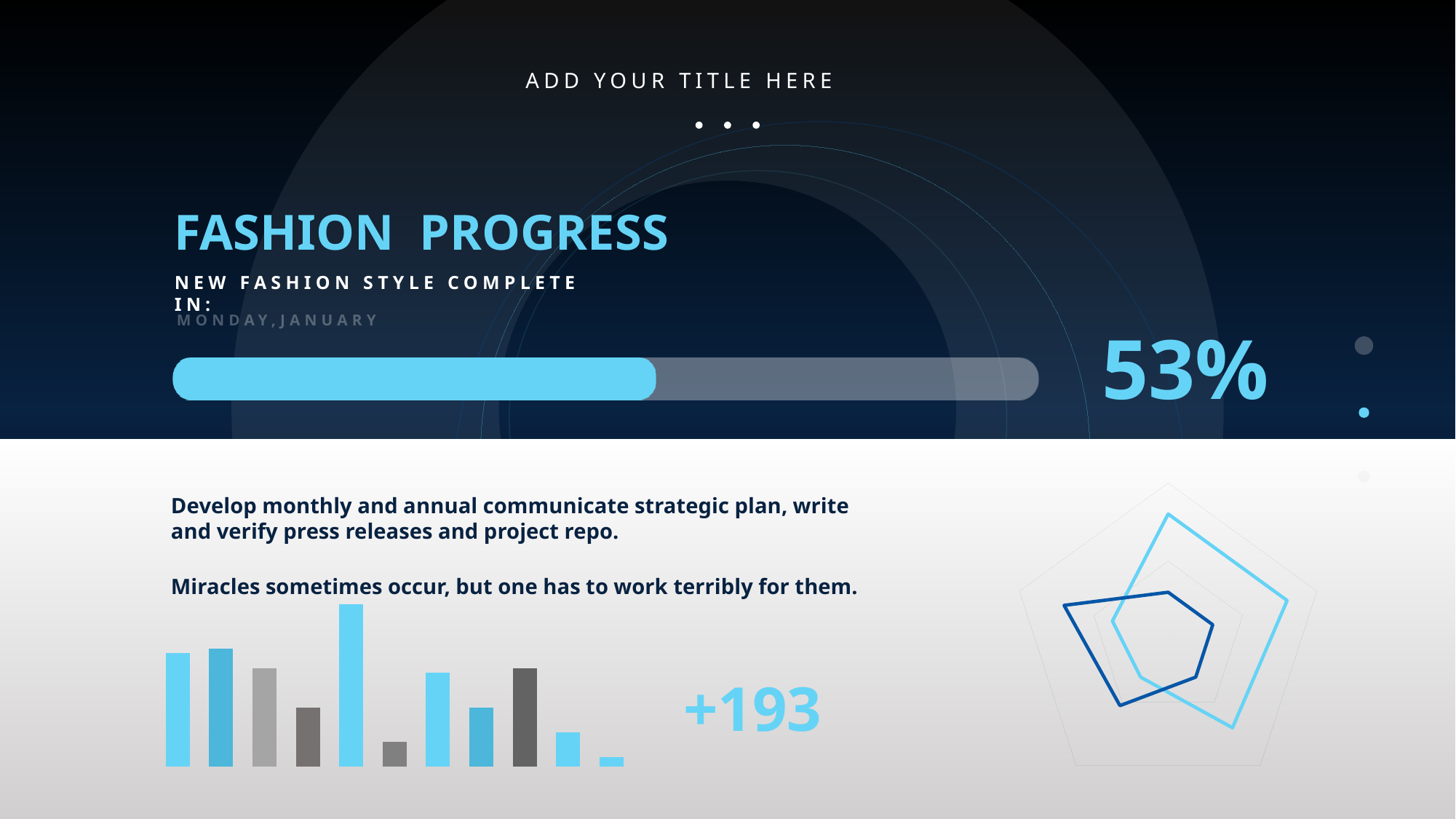
How many axes (vertices) does the radar chart at the bottom right have? 5 What kind of chart is shown at the bottom left of the slide? bar chart How many data series (polygons) are plotted on the radar chart at the bottom right? 2 In the bar chart at the bottom left, which bar is the tallest, counting from the left? the fifth bar What number is printed in large light-blue text to the right of the bar chart? +193 What colour is the tallest bar in the bar chart at the bottom left? light blue What kind of chart is shown at the bottom right of the slide? radar chart What percentage is shown next to the progress bar in the upper part of the slide? 53% How many bars does the bar chart at the bottom left contain? 11 In the bar chart at the bottom left, which bar is the shortest, counting from the left? the eleventh (last) bar In the bar chart at the bottom left, is the first bar from the left taller or shorter than the fifth bar? shorter In the bar chart at the bottom left, is the ninth bar from the left taller or shorter than the tenth bar? taller